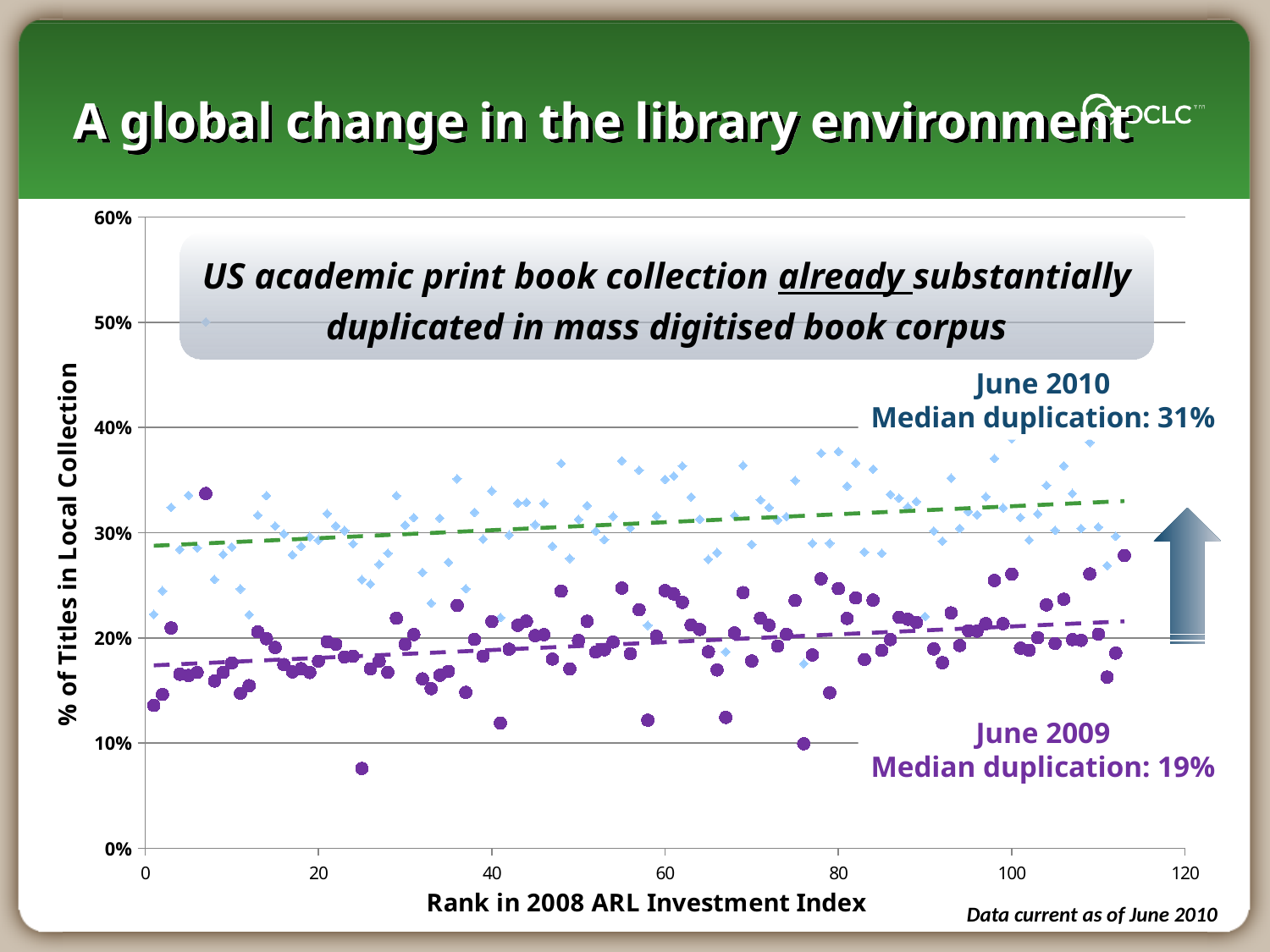
Is the lowest June 2009 data point greater or less than 10%? less What is the median duplication for June 2009? 19% What is the label of the vertical axis? % of Titles in Local Collection Which year has the higher median duplication, June 2009 or June 2010? June 2010 By how many percentage points does the June 2010 median duplication exceed the June 2009 median duplication? 12 percentage points Do the dashed trend lines rise or fall as the rank in the 2008 ARL Investment Index increases? Rise Is the highest June 2009 data point greater or less than 40%? less How many data series are plotted on the chart? 2 What is the median duplication for June 2010? 31% What type of chart is shown on the slide? Scatter chart What is the label of the horizontal axis? Rank in 2008 ARL Investment Index